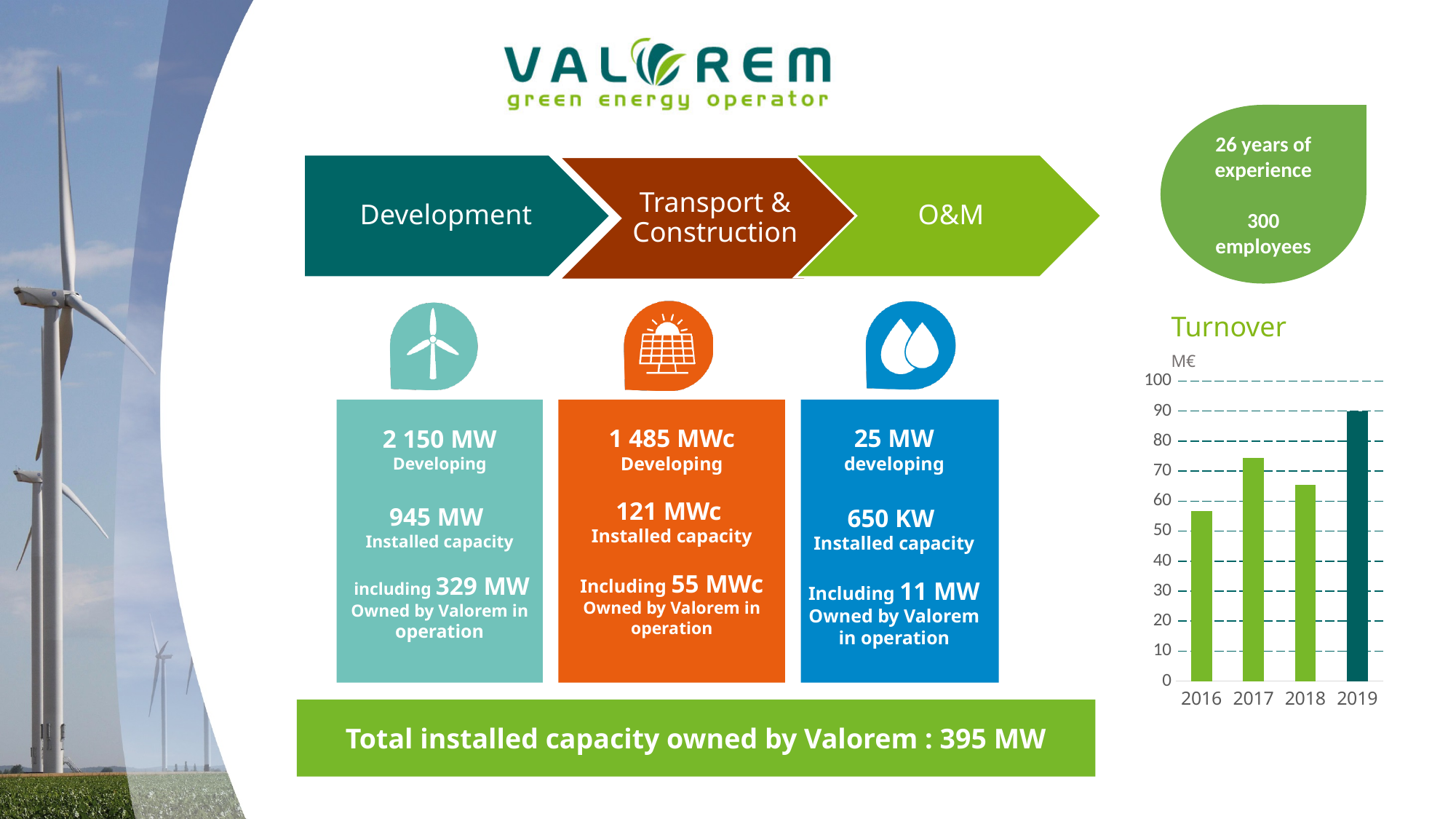
What is the maximum value shown on the y axis of the Turnover chart? 100 What kind of chart is the Turnover chart? bar chart Which year has the lowest turnover in the Turnover chart? 2016 In the Turnover chart, is the turnover for 2017 or 2018 larger? 2017 Which year has the highest turnover in the Turnover chart? 2019 What unit is shown on the y axis of the Turnover chart? M€ In the Turnover chart, is the value for 2019 greater or less than 80? greater In the Turnover chart, does turnover rise or fall from 2018 to 2019? rise In the Turnover chart, is the value for 2016 greater or less than 60? less How many years are shown on the x axis of the Turnover chart? 4 In the Turnover chart, is the value for 2018 greater or less than 70? less